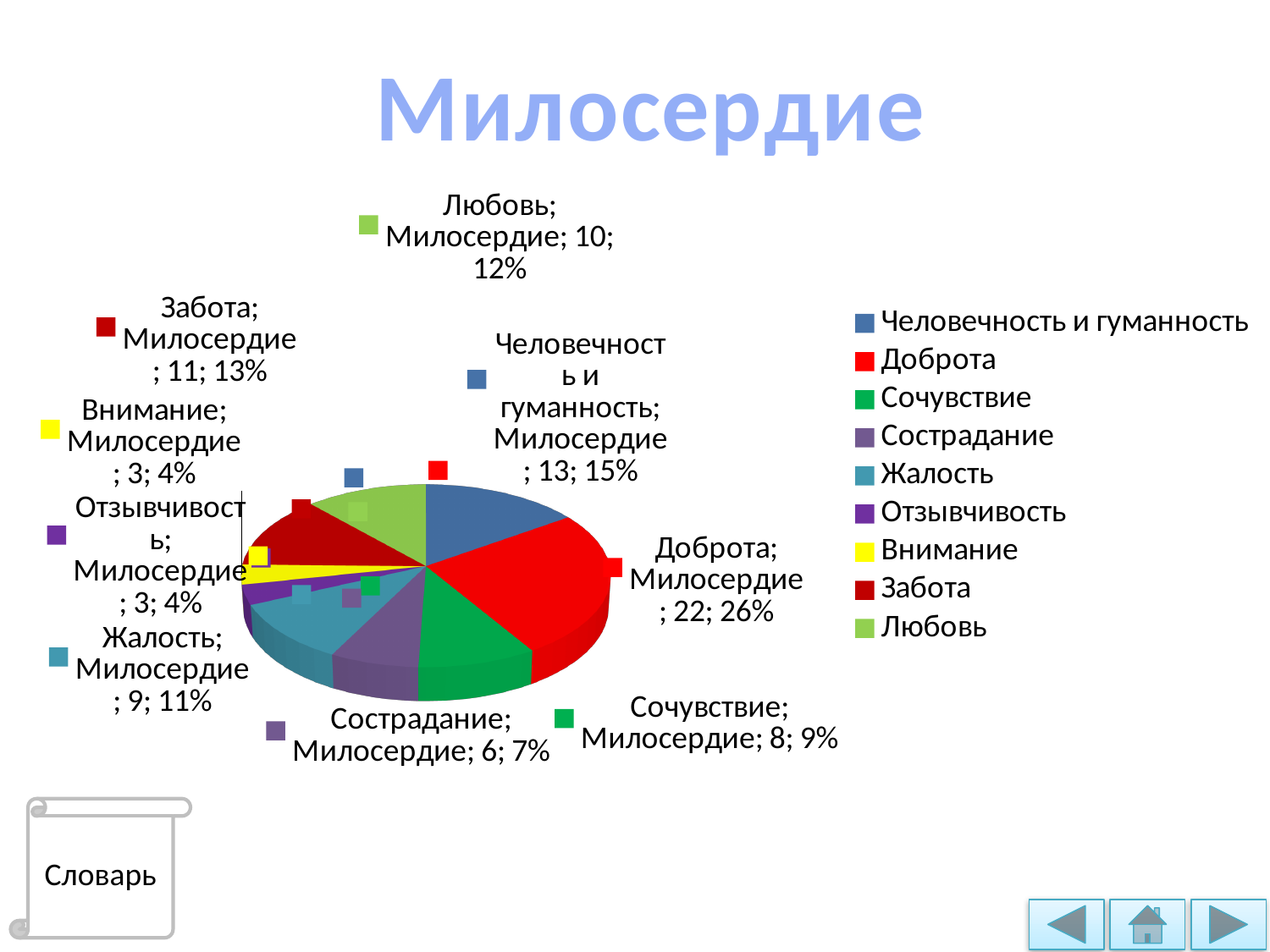
What kind of chart is shown on the slide? pie chart What is the value for Сострадание? 6 Which categories have the smallest value? Отзывчивость and Внимание What is the title of the slide above the chart? Милосердие How many categories does the pie chart have? 9 What is the value for Доброта? 22 What percentage share does Любовь have? 12% What is the difference between the values for Доброта and Сочувствие? 14 Which category has the largest slice? Доброта What percentage share does Человечность и гуманность have? 15% What is the value for Забота? 11 Which is larger, the value for Жалость or the value for Сострадание? Жалость